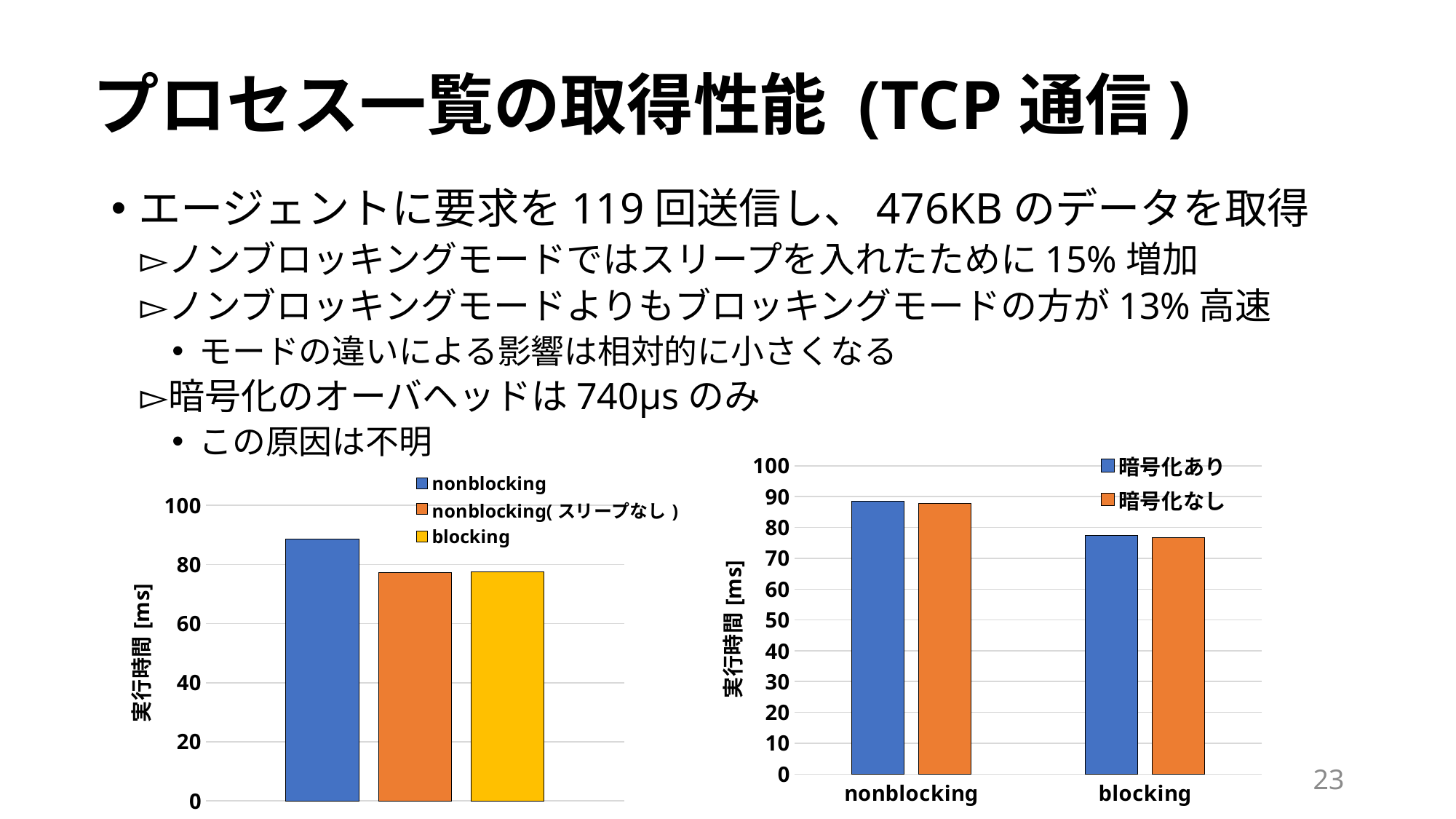
In the right chart, is the value for 暗号化あり in the nonblocking category greater or less than 80? greater In the left chart, which series has the highest execution time? nonblocking In the left chart, is the value for nonblocking greater or less than 80? greater In the right chart, is the value for 暗号化なし in the blocking category greater or less than 80? less In the left chart, what colour is the bar for blocking? yellow How many series does the legend of the right chart list? 2 How many series does the legend of the left chart list? 3 In the right chart, how many categories are shown on the x axis? 2 What kind of chart is the left chart on the slide? bar chart In the right chart, which category has the higher execution time for 暗号化あり, nonblocking or blocking? nonblocking What is the y-axis title of the right chart? 実行時間 [ms]